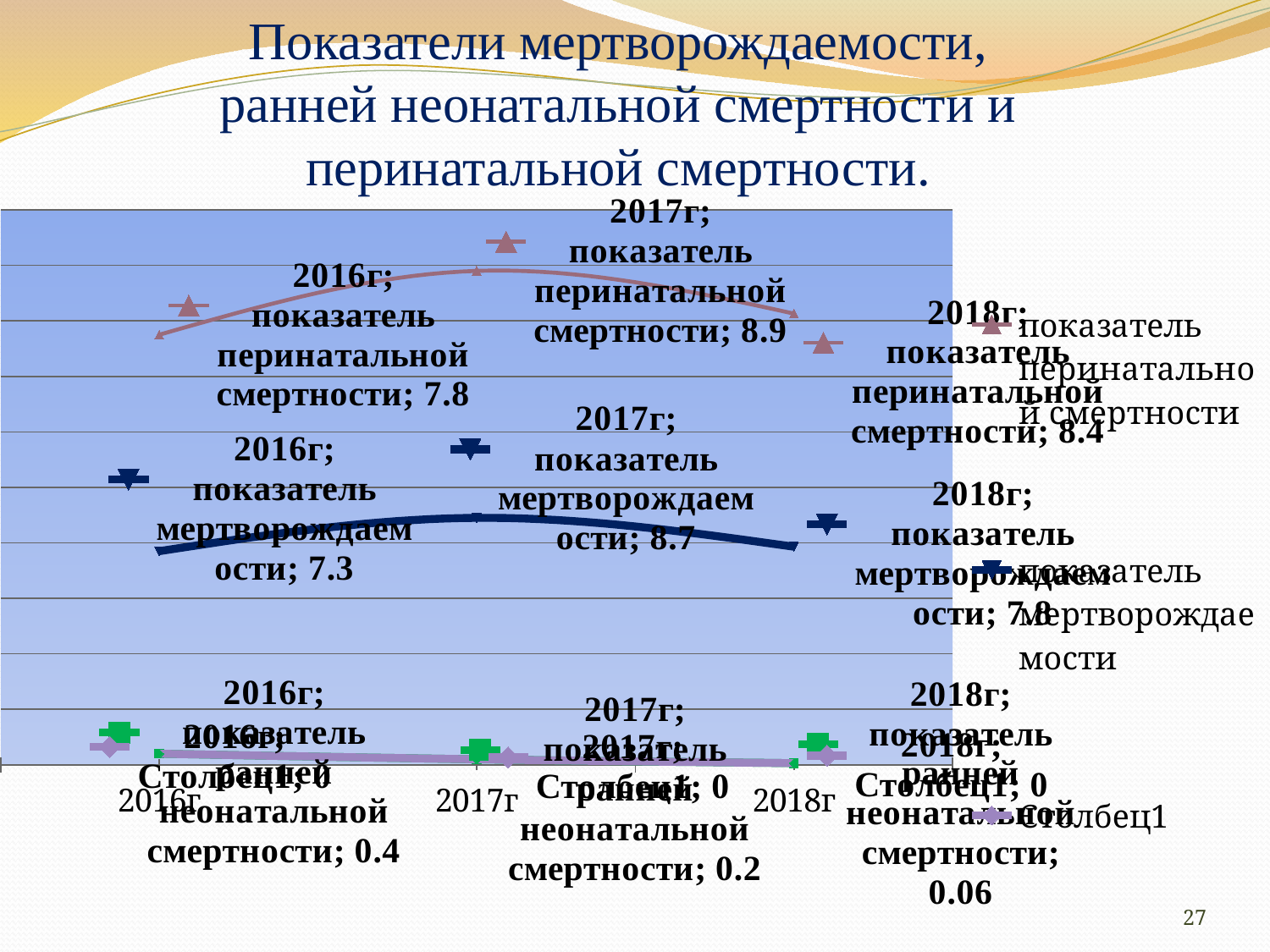
Does показатель ранней неонатальной смертности rise or fall from 2016г to 2018г? fall What is the value of показатель ранней неонатальной смертности in 2018г? 0.06 What is the difference between показатель перинатальной смертности in 2017г and 2016г? 1.1 What type of chart is shown on the slide? line chart What is the value of показатель перинатальной смертности in 2017г? 8.9 What is the difference between показатель мертворождаемости in 2017г and 2018г? 0.9 What is the value of показатель мертворождаемости in 2016г? 7.3 How many years are shown on the x axis of the chart? 3 Which is larger in 2018г: показатель перинатальной смертности or показатель мертворождаемости? показатель перинатальной смертности In which year is показатель перинатальной смертности the highest? 2017г What is the value of показатель перинатальной смертности in 2018г? 8.4 In which year is показатель ранней неонатальной смертности the lowest? 2018г